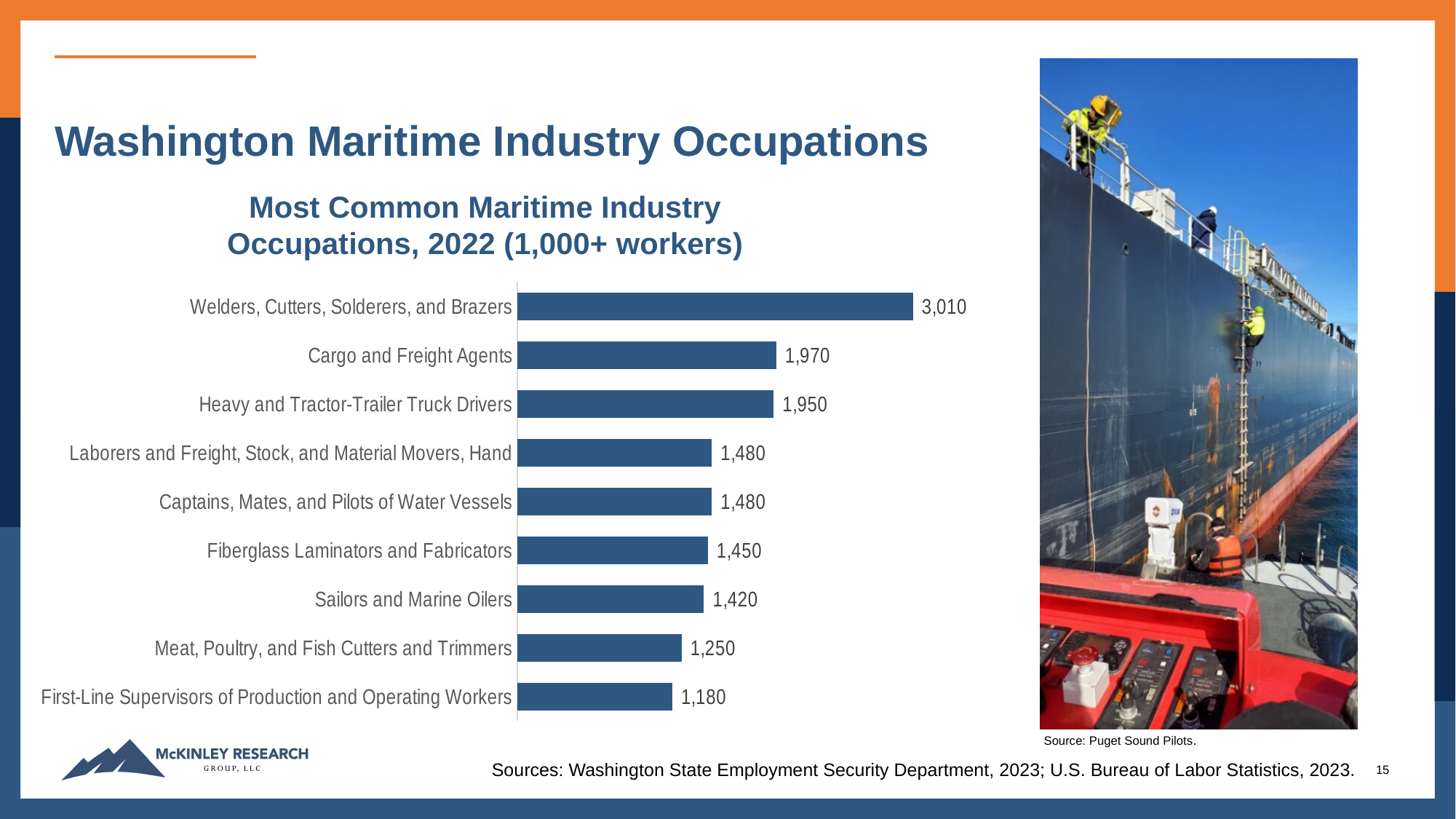
What is the difference between the values for Meat, Poultry, and Fish Cutters and Trimmers and First-Line Supervisors of Production and Operating Workers? 70 What is the title of the chart? Most Common Maritime Industry Occupations, 2022 (1,000+ workers) Which occupation has the highest value? Welders, Cutters, Solderers, and Brazers How many occupations are shown in the chart? 9 What is the difference between the values for Welders, Cutters, Solderers, and Brazers and Cargo and Freight Agents? 1,040 What kind of chart is shown on the slide? Bar chart What is the value for Welders, Cutters, Solderers, and Brazers? 3,010 Which is larger, the value for Fiberglass Laminators and Fabricators or the value for Sailors and Marine Oilers? Fiberglass Laminators and Fabricators What is the value for Sailors and Marine Oilers? 1,420 What is the value for First-Line Supervisors of Production and Operating Workers? 1,180 What is the value for Cargo and Freight Agents? 1,970 Which occupation has the lowest value? First-Line Supervisors of Production and Operating Workers